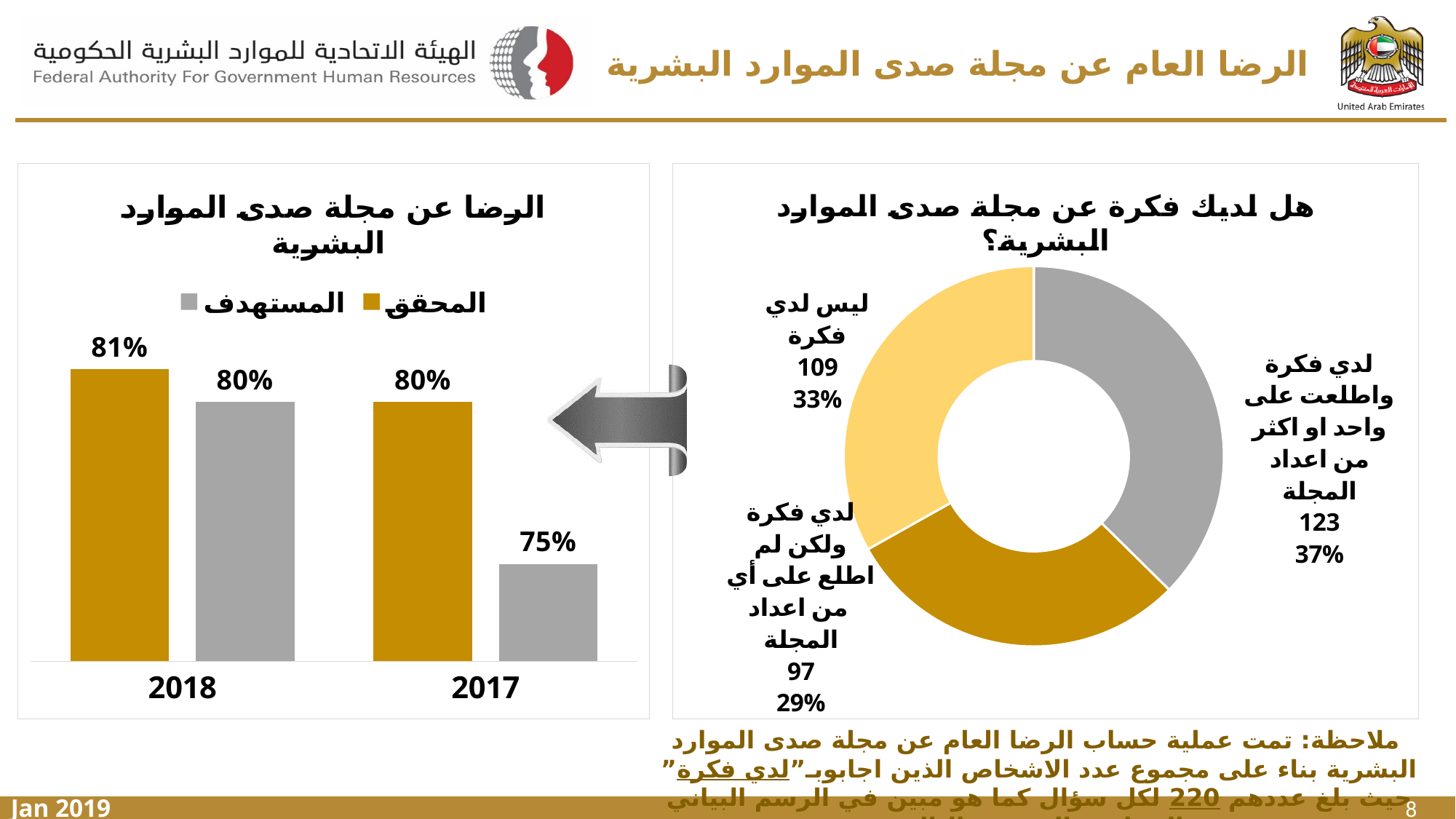
In the donut chart on the right, how many categories are shown? 3 In the bar chart on the left, what is the المحقق value for 2018? 81% What type of chart is the chart on the left of the slide? Bar chart In the bar chart on the left, which is larger for 2018: المحقق or المستهدف? المحقق In the bar chart on the left, what is the difference between the المحقق and المستهدف values for 2017? 5% In the donut chart on the right, which category has the smallest count? لدي فكرة ولكن لم اطلع على أي من اعداد المجلة In the bar chart on the left, what is the المستهدف value for 2017? 75% In the donut chart on the right, what share of respondents said لدي فكرة واطلعت على واحد او اكثر من اعداد المجلة? 37% In the bar chart on the left, how many series does the legend list? 2 In the donut chart on the right, how many respondents answered ليس لدي فكرة? 109 In the bar chart on the left, what is the المحقق value for 2017? 80% In the donut chart on the right, what is the total number of respondents across all three categories? 329